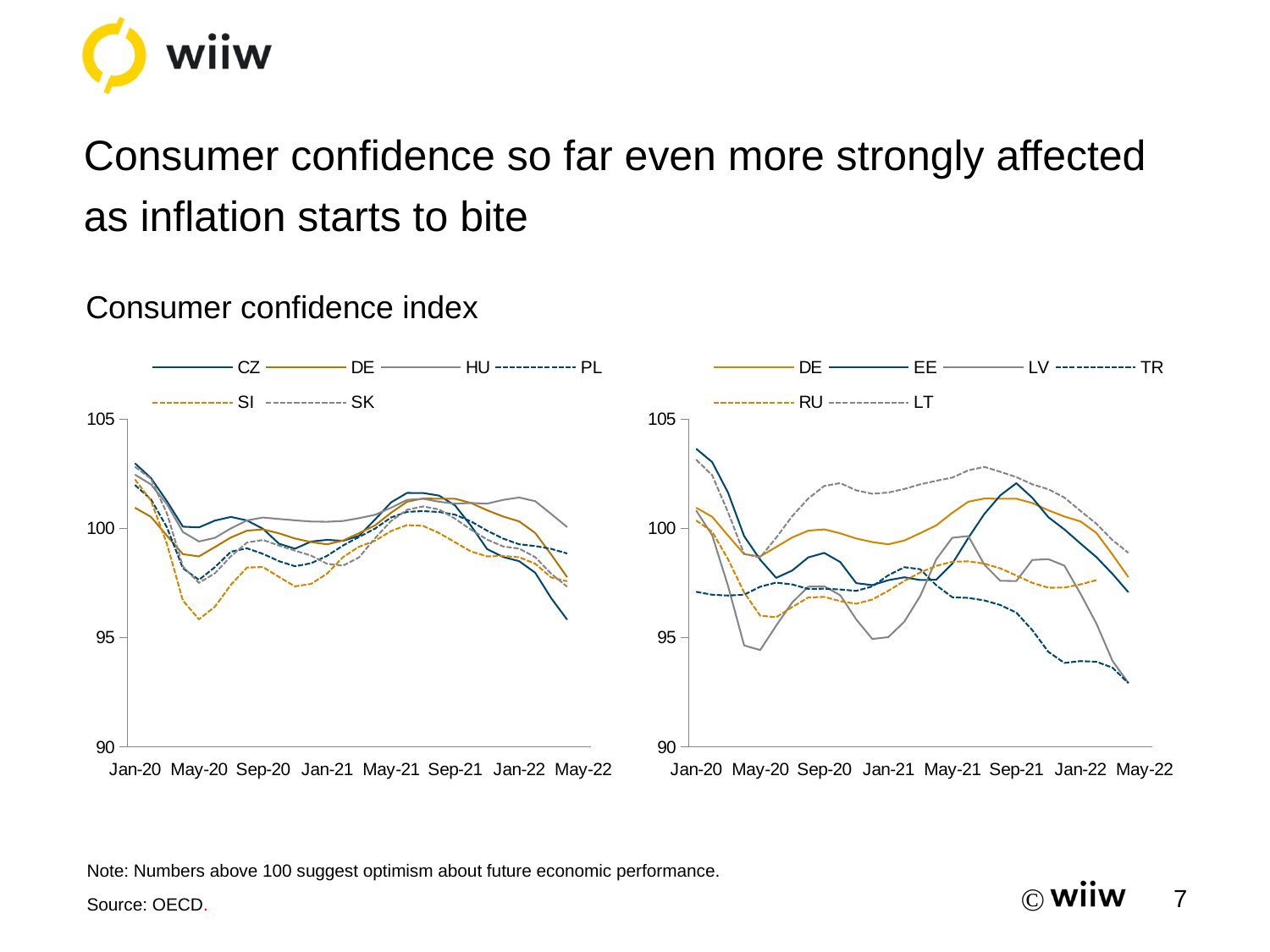
In the right chart, at May-22, which is larger: DE or TR? DE In the right chart, is the value for EE at Jan-20 greater or less than 100? greater In the left chart, is the value for CZ at May-22 greater or less than 100? less In the left chart, does the CZ line rise or fall between Sep-21 and May-22? fall In the left chart, is the value for SI at May-20 greater or less than 100? less How many series does the legend of the right chart list? 6 What kind of chart is the left chart on the slide? line chart In the left chart, which series has the lowest value at May-20? SI How many series does the legend of the left chart list? 6